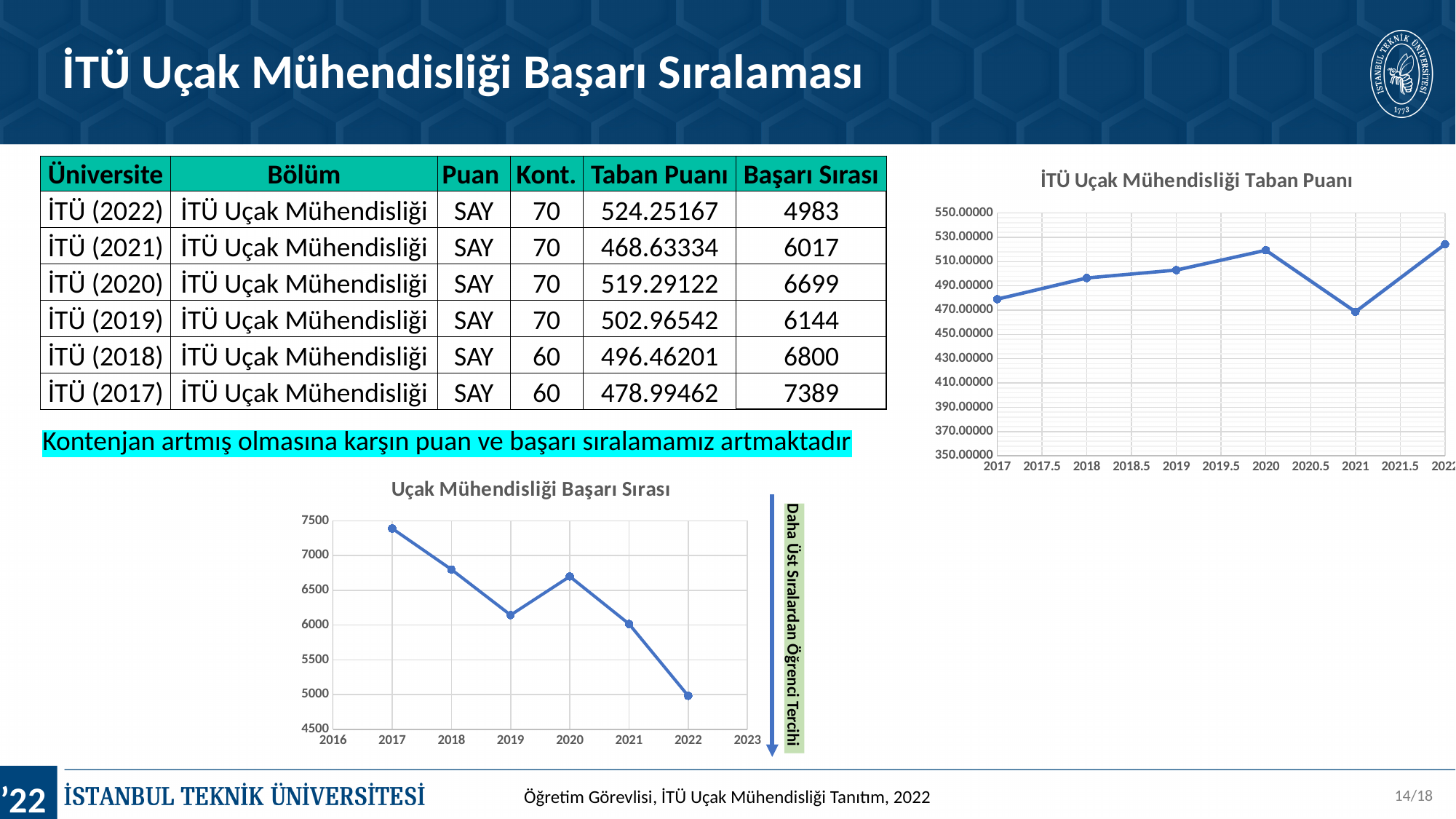
In the "Uçak Mühendisliği Başarı Sırası" chart, is the value for 2020 larger or smaller than the value for 2021? larger How many data points are plotted in the "Uçak Mühendisliği Başarı Sırası" chart? 6 What kind of chart is the "İTÜ Uçak Mühendisliği Taban Puanı" chart on the right of the slide? line chart In the "Uçak Mühendisliği Başarı Sırası" chart, is the value for 2017 greater or less than 7000? greater In the "İTÜ Uçak Mühendisliği Taban Puanı" chart, which year has the highest value? 2022 In the "İTÜ Uçak Mühendisliği Taban Puanı" chart, which year has the lowest value? 2021 What kind of chart is the "Uçak Mühendisliği Başarı Sırası" chart at the bottom left of the slide? line chart In the "İTÜ Uçak Mühendisliği Taban Puanı" chart, is the value for 2022 greater or less than 510.00000? greater In the "Uçak Mühendisliği Başarı Sırası" chart, which year has the highest value? 2017 In the "Uçak Mühendisliği Başarı Sırası" chart, which year has the lowest value? 2022 In the "Uçak Mühendisliği Başarı Sırası" chart, is the value for 2019 greater or less than 6500? less